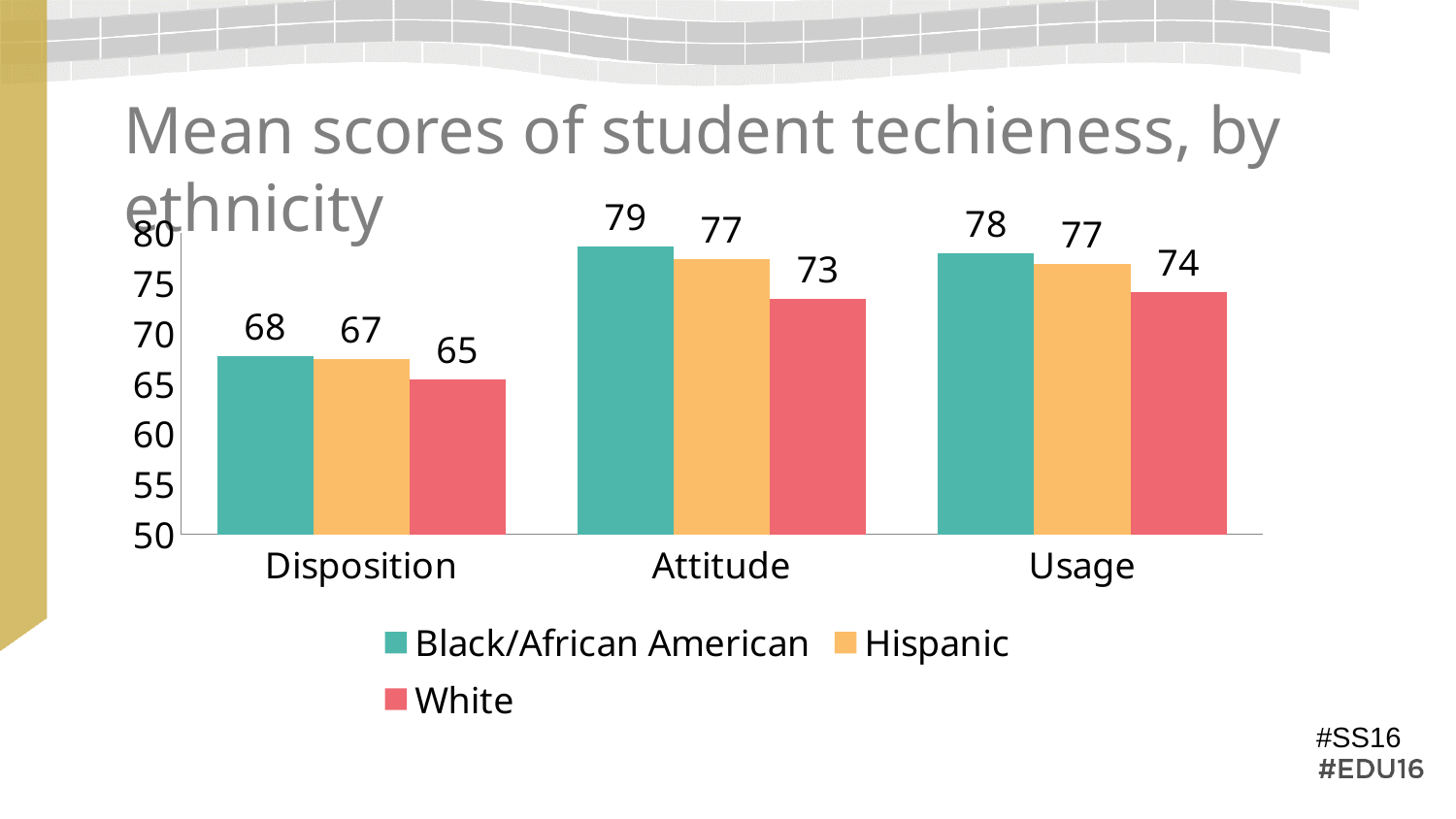
What is the mean Attitude score for White students? 73 Which category has the highest score for Black/African American students? Attitude What is the mean Disposition score for Black/African American students? 68 What is the title of the chart? Mean scores of student techieness, by ethnicity Which category has the lowest score for White students? Disposition How many series does the legend list? 3 How many categories are shown on the x axis? 3 What kind of chart is shown on the slide? bar chart What is the mean Usage score for Hispanic students? 77 What is the difference between the Attitude scores of Black/African American and White students? 6 Which is larger: the Usage score for Black/African American students or for White students? Black/African American Is the Disposition score for White students greater or less than 70? less